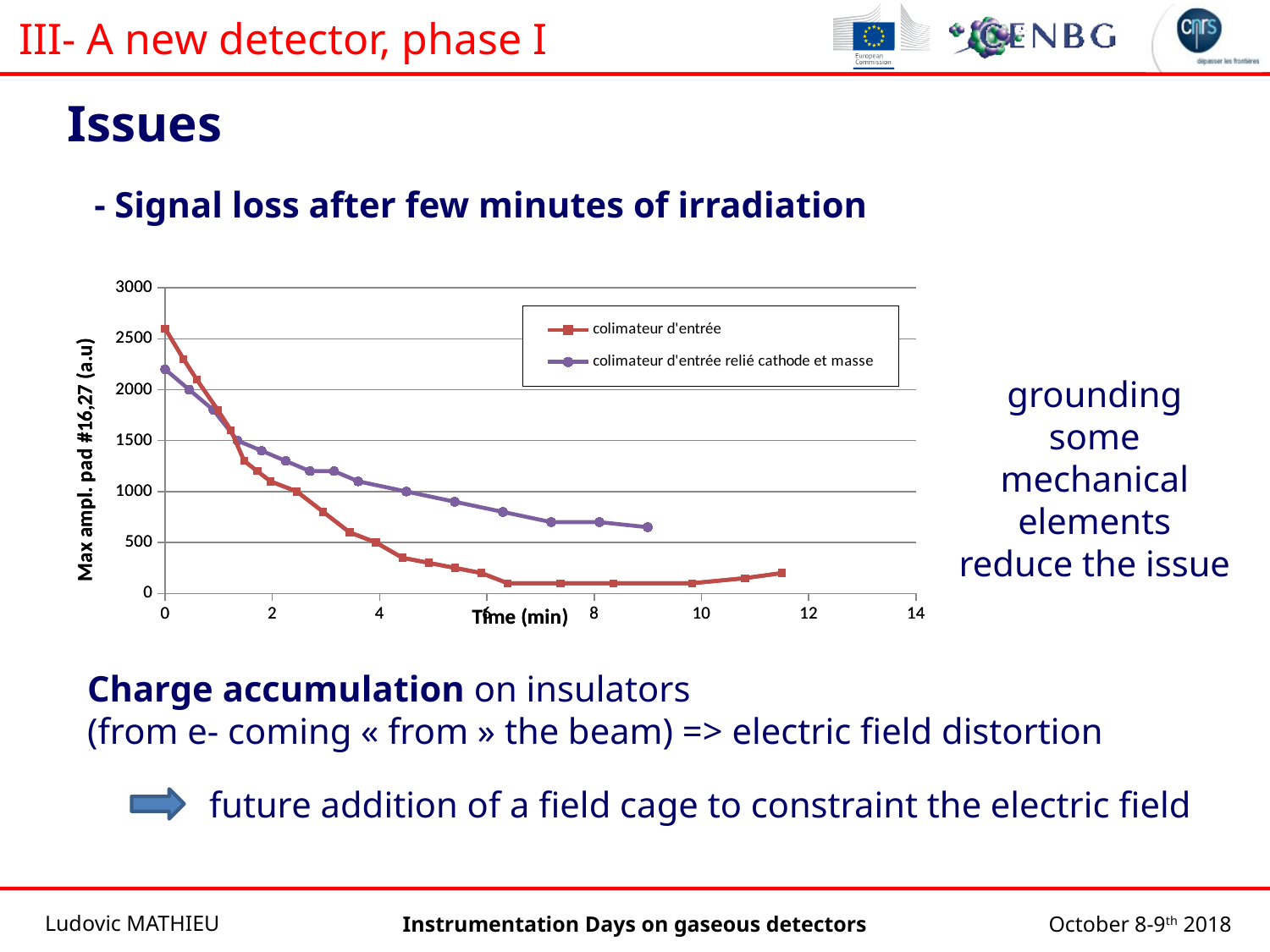
Is the value of 'colimateur d'entrée relié cathode et masse' at around 8 minutes greater or less than 500? greater How many series does the chart's legend list? 2 What is the label of the chart's y axis? Max ampl. pad #16,27 (a.u) At time 0, which series has the higher value? colimateur d'entrée Do the values of the 'colimateur d'entrée' series rise or fall as time increases from 0 to 6 minutes? fall Is the value of 'colimateur d'entrée' at time 0 greater or less than 2000? greater Is the value of 'colimateur d'entrée relié cathode et masse' at time 0 greater or less than 2500? less At around 6 minutes, which series has the higher value? colimateur d'entrée relié cathode et masse What are the two series named in the chart's legend? colimateur d'entrée; colimateur d'entrée relié cathode et masse What kind of chart is shown on the slide? line chart